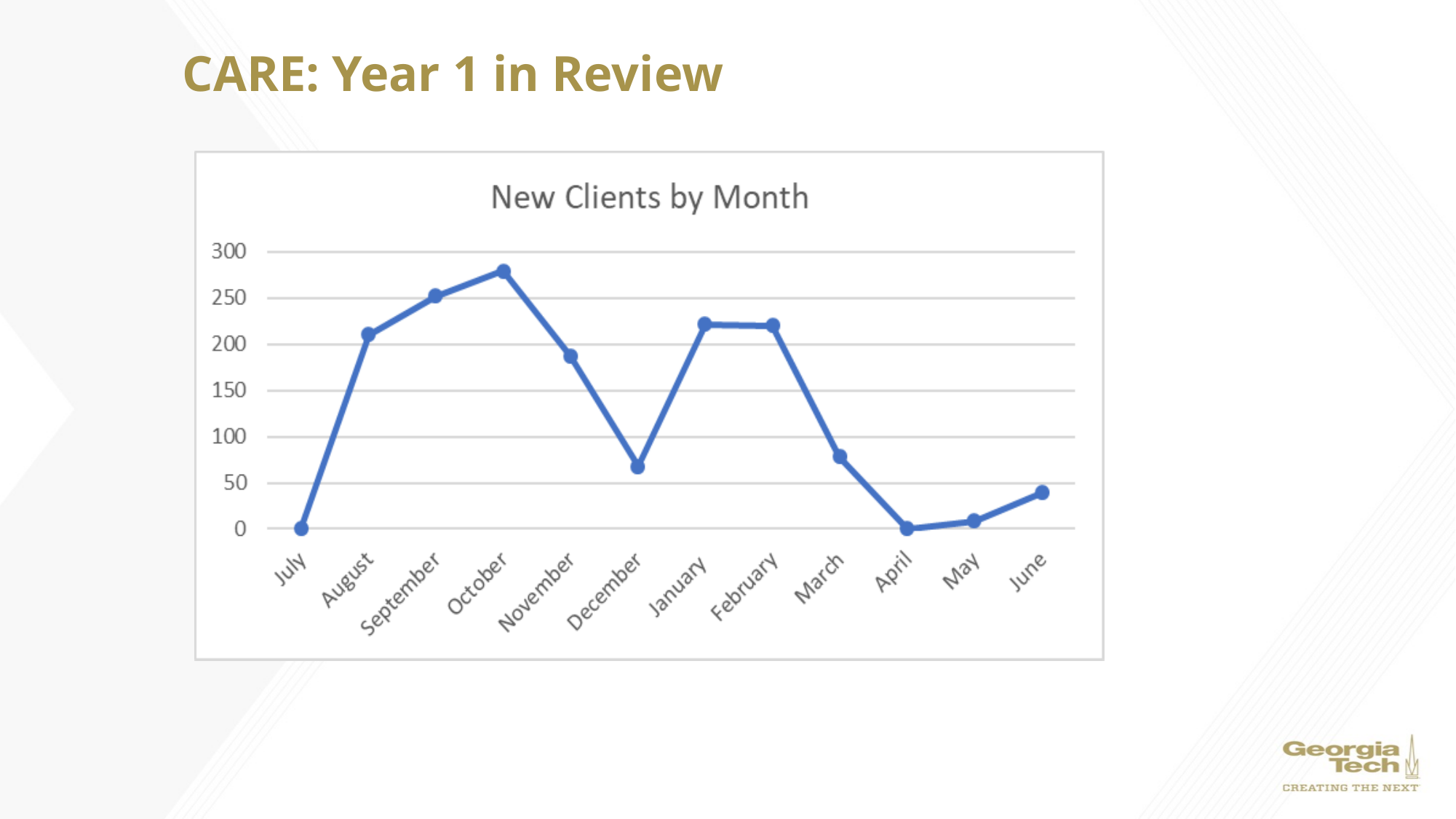
What is the value for April? 0 Do the values rise or fall from July to October? rise Is the value for June greater or less than 50? less How many months are plotted on the x axis? 12 Is the value for December greater or less than 100? less What kind of chart is shown on the slide? line chart What is the title of the chart? New Clients by Month Which is larger, the value for October or the value for November? October What is the value for July? 0 Which month has the highest number of new clients? October Is the value for November greater or less than 150? greater